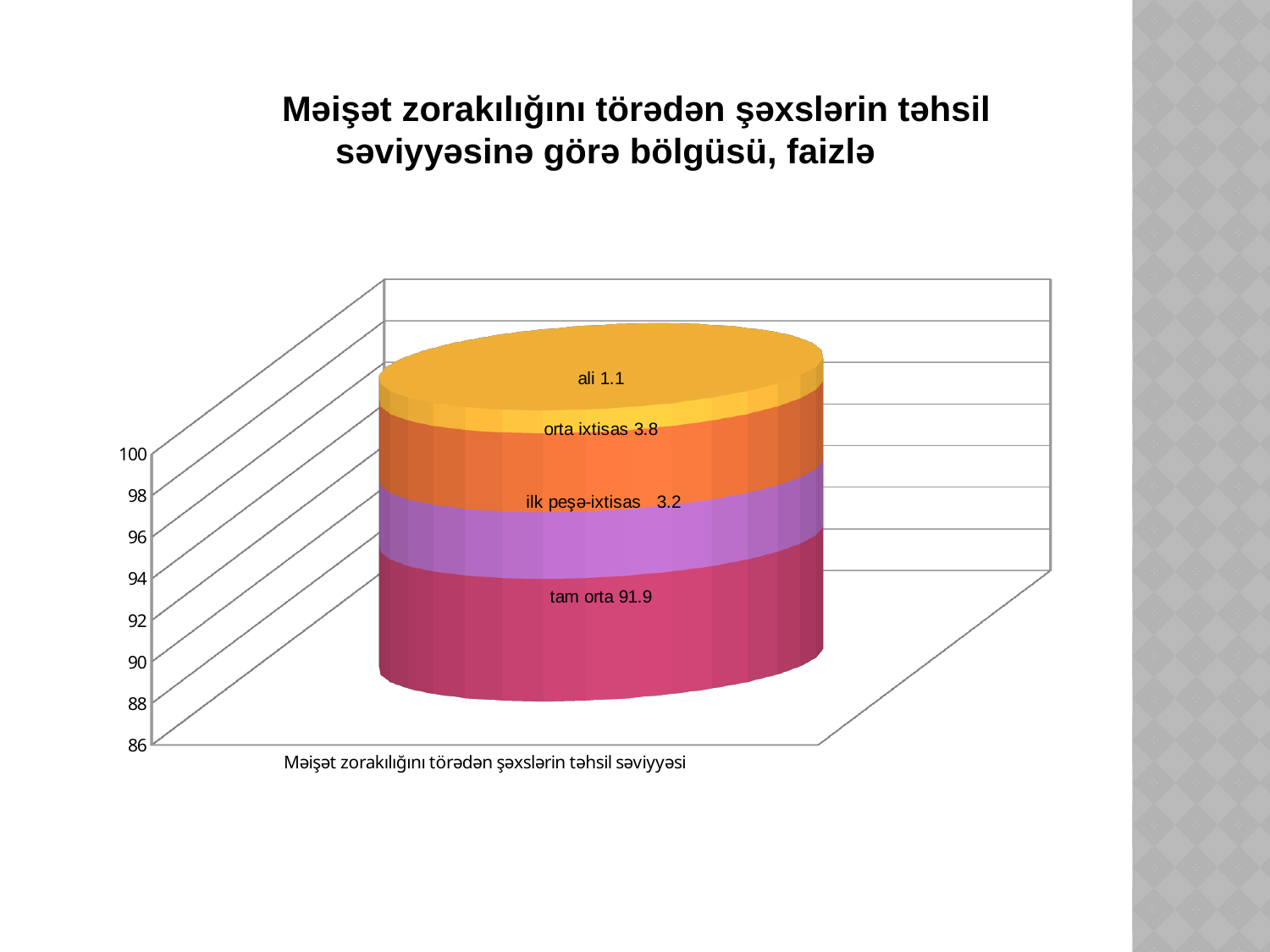
What is the value for orta ixtisas? 3.8 What is the difference between the values for tam orta and ali? 90.8 Which education level has the lowest value? ali What is the difference between the values for orta ixtisas and ilk peşə-ixtisas? 0.6 What is the total of the stacked bar? 100 What is the value for tam orta? 91.9 What is the value for ali? 1.1 What is the value for ilk peşə-ixtisas? 3.2 How many segments make up the stacked bar? 4 What kind of chart is shown on the slide? stacked bar chart Which is larger, the value for orta ixtisas or the value for ilk peşə-ixtisas? orta ixtisas Which education level has the highest value? tam orta